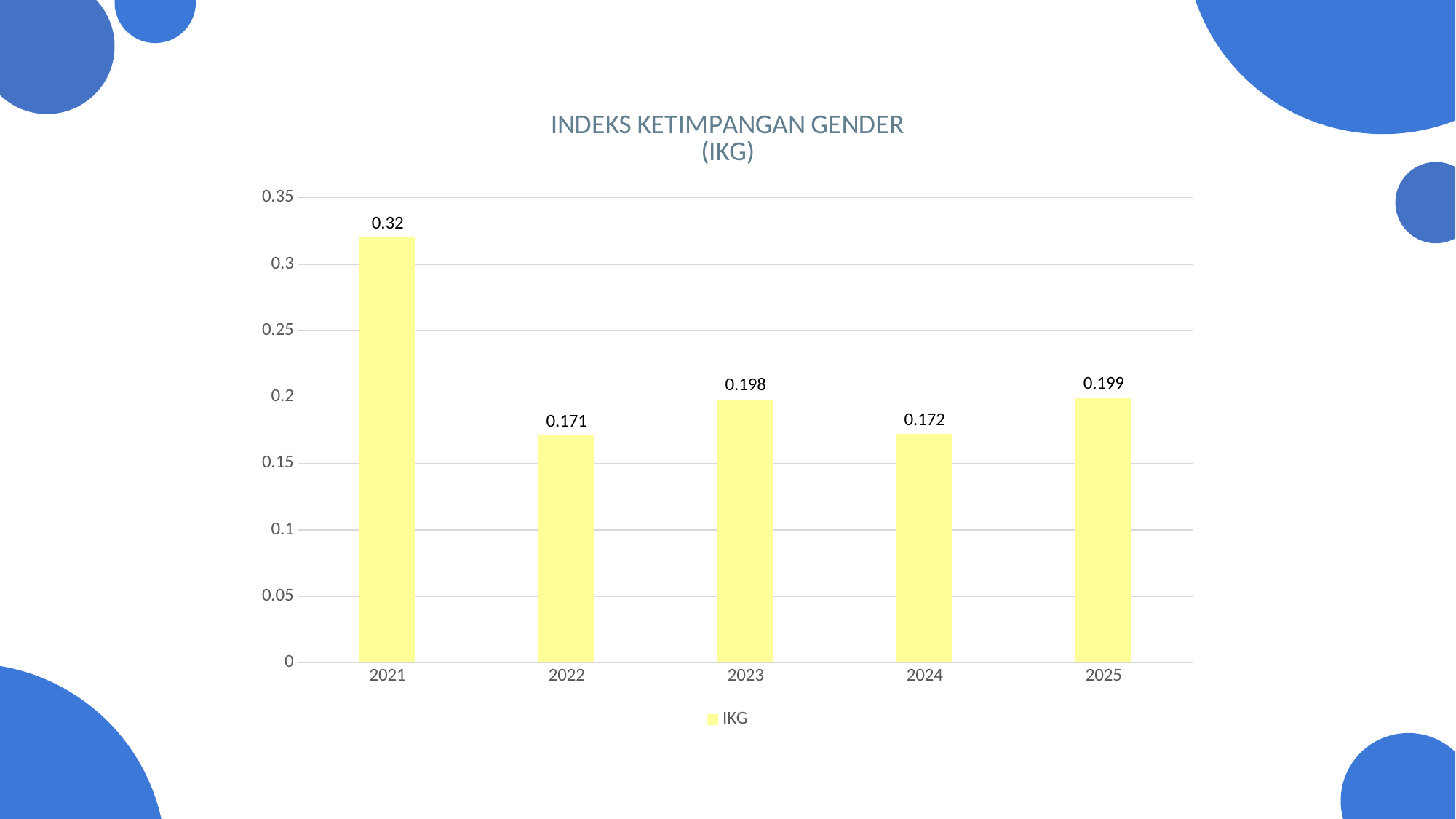
What kind of chart is shown on the slide? bar chart Which year has the lowest IKG value? 2022 How many years are shown on the x axis? 5 What is the IKG value for 2025? 0.199 What is the difference between the IKG values for 2021 and 2022? 0.149 Which year has a larger IKG value, 2023 or 2024? 2023 What is the IKG value for 2023? 0.198 How many series does the legend list? 1 Is the IKG value for 2021 greater or less than 0.3? greater What is the title of the chart? INDEKS KETIMPANGAN GENDER (IKG) Which year has the highest IKG value? 2021 What is the IKG value for 2021? 0.32